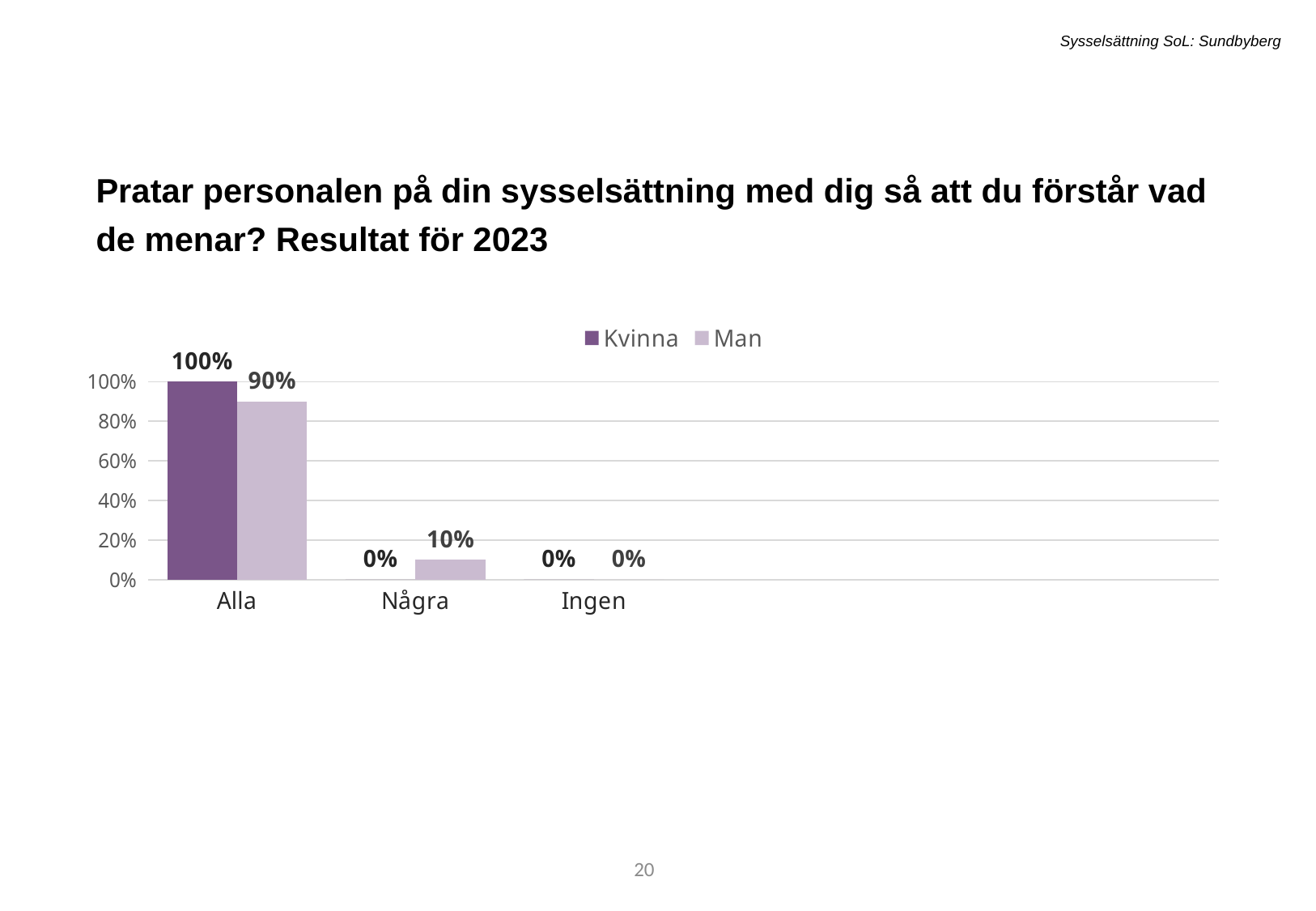
What are the two series names listed in the legend? Kvinna and Man What kind of chart is shown on the slide? Bar chart What is the value for Man in the Alla category? 90% Which category has the highest value for Man? Alla In the Alla category, which series has the larger value, Kvinna or Man? Kvinna Do the values for Man rise or fall from Alla to Ingen? Fall What is the value for Man in the Några category? 10% What is the difference between the Kvinna and Man values in the Alla category? 10% What is the value for Kvinna in the Alla category? 100% What is the value for Kvinna in the Några category? 0% How many series does the legend list? 2 How many categories are shown on the x axis? 3